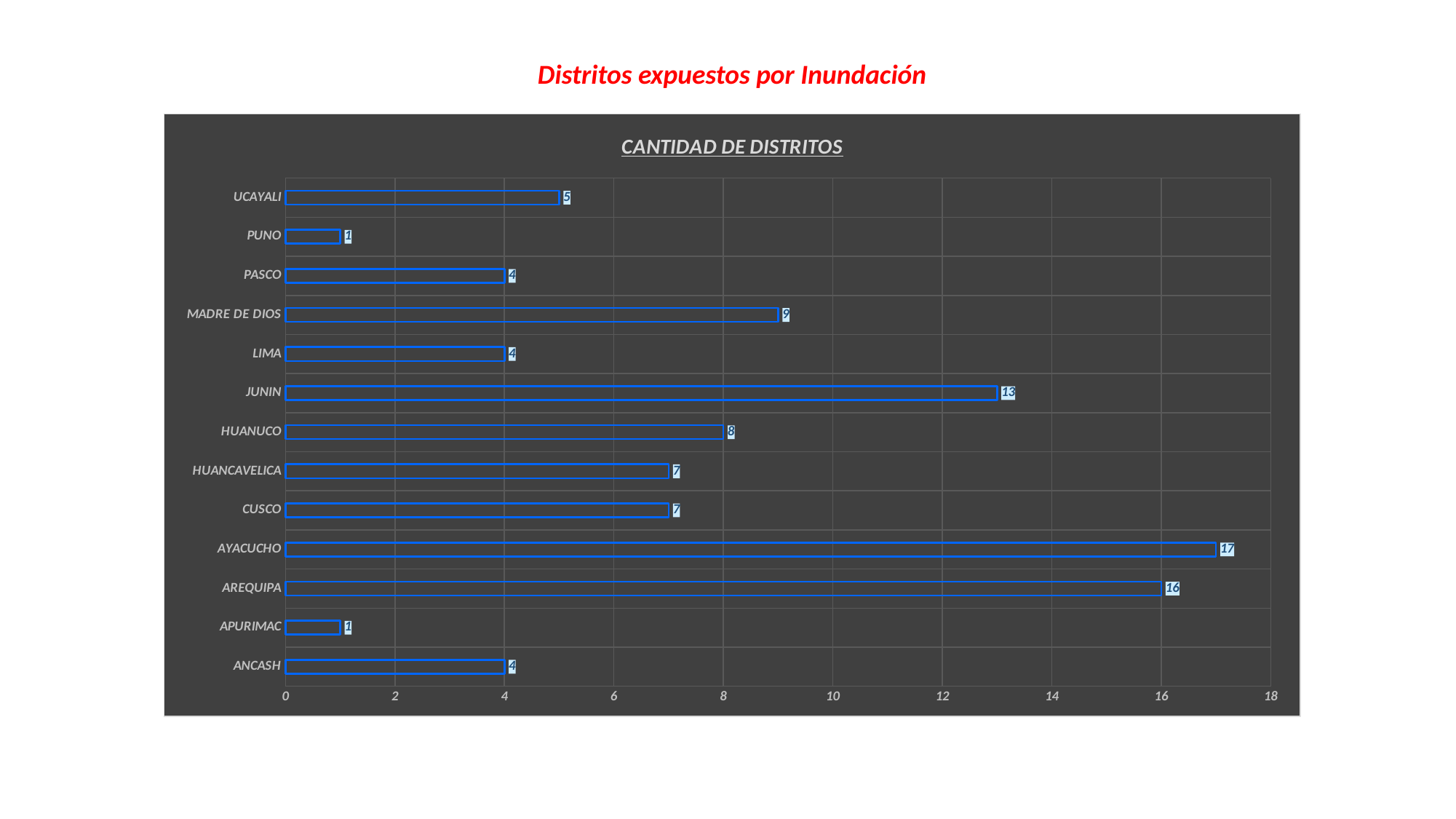
Which is larger, the value for UCAYALI or the value for PASCO? UCAYALI What kind of chart is shown? bar chart What is the difference between the values for JUNIN and HUANUCO? 5 Which category has the highest value? AYACUCHO How many categories are shown on the chart? 13 What is the difference between the values for AYACUCHO and AREQUIPA? 1 What is the value for MADRE DE DIOS? 9 What is the value for HUANCAVELICA? 7 What is the value for JUNIN? 13 What is the title of the chart? CANTIDAD DE DISTRITOS What is the value for AYACUCHO? 17 Is the value for AREQUIPA greater or less than 10? greater